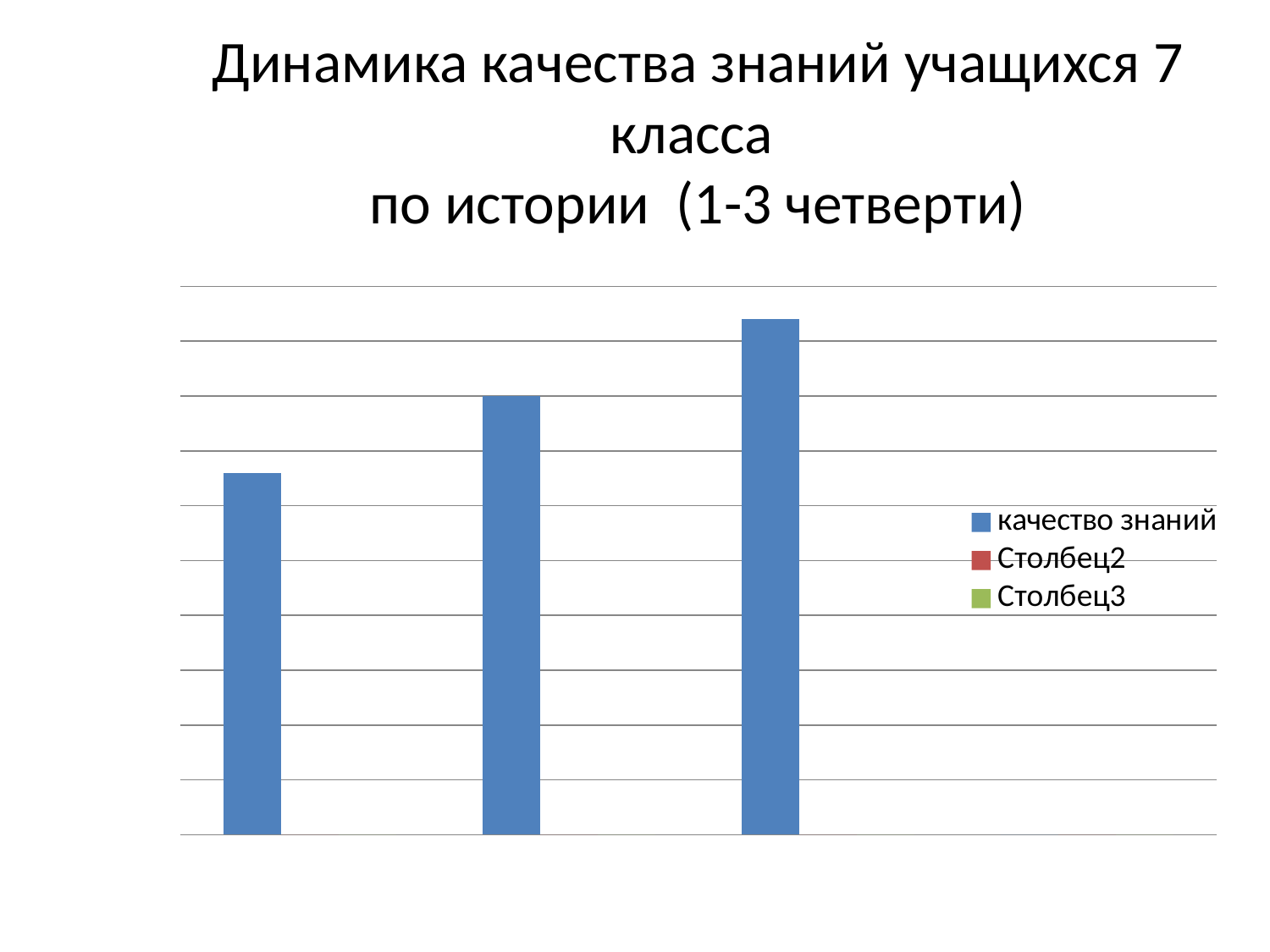
What is the first legend entry of the chart? качество знаний How many bars are plotted in the chart? 3 Do the bar values rise or fall from left to right? rise Which is larger, the middle bar or the leftmost bar? the middle bar What colour are the bars in the chart? blue What kind of chart is shown on the slide? bar chart Which bar is the tallest: the leftmost, the middle, or the rightmost? the rightmost Which bar is the shortest: the leftmost, the middle, or the rightmost? the leftmost Which is larger, the middle bar or the rightmost bar? the rightmost bar How many series does the legend list? 3